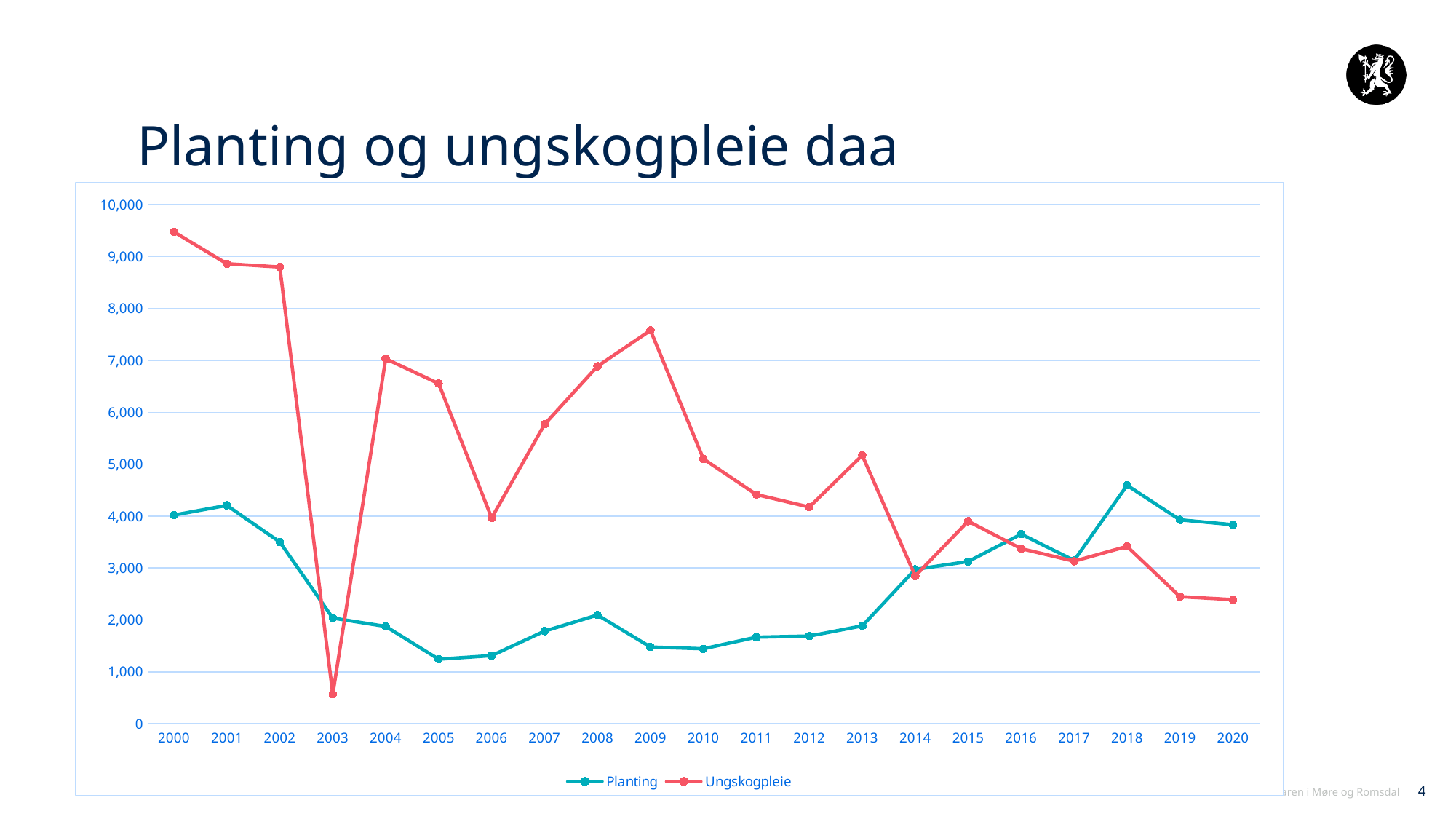
In which year is the Ungskogpleie value lowest? 2003 In 2018, which series has the larger value, Planting or Ungskogpleie? Planting How many years are plotted along the x axis? 21 What is the title of the slide containing the chart? Planting og ungskogpleie daa How many series does the legend list? 2 Is the Ungskogpleie value for 2003 greater or less than 1,000? less In 2000, which series has the larger value, Planting or Ungskogpleie? Ungskogpleie Is the Planting value for 2005 greater or less than 2,000? less What kind of chart is shown on the slide? line chart Is the Ungskogpleie value for 2009 greater or less than 7,000? greater In which year is the Planting value highest? 2018 In which year is the Ungskogpleie value highest? 2000